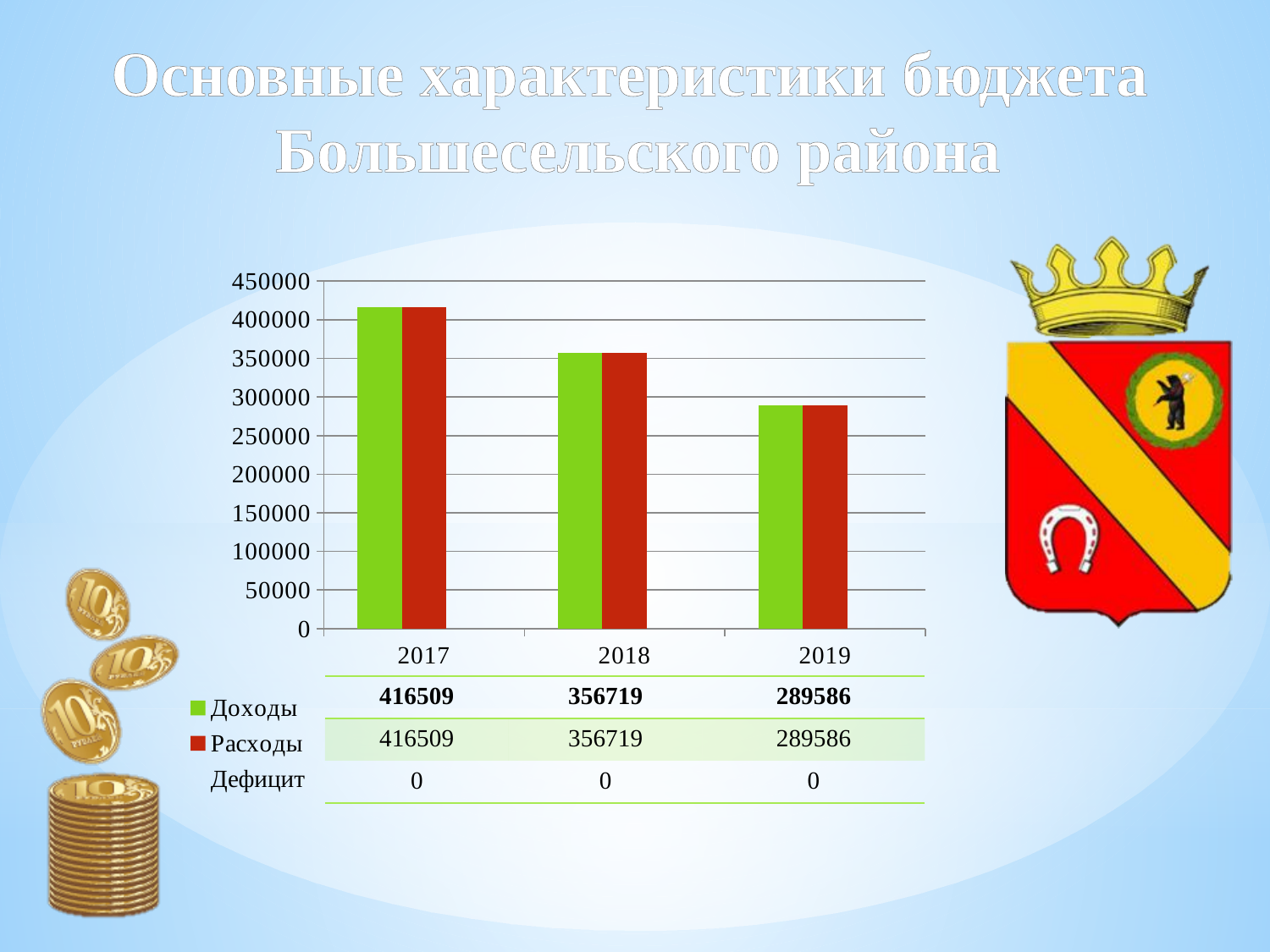
Do the Доходы values rise or fall from 2017 to 2019? fall What type of chart is shown on the slide? bar chart What is the value of Расходы for 2018? 356719 What is the value of Доходы for 2017? 416509 What is the difference between Доходы in 2017 and Доходы in 2019? 126923 Which is larger: Доходы in 2018 or Доходы in 2019? Доходы in 2018 What is the value of Доходы for 2019? 289586 In which year is Доходы the highest? 2017 What is the difference between Расходы in 2017 and Расходы in 2018? 59790 In which year is Расходы the lowest? 2019 How many years are shown on the x axis of the chart? 3 What is the value of Дефицит for 2018? 0